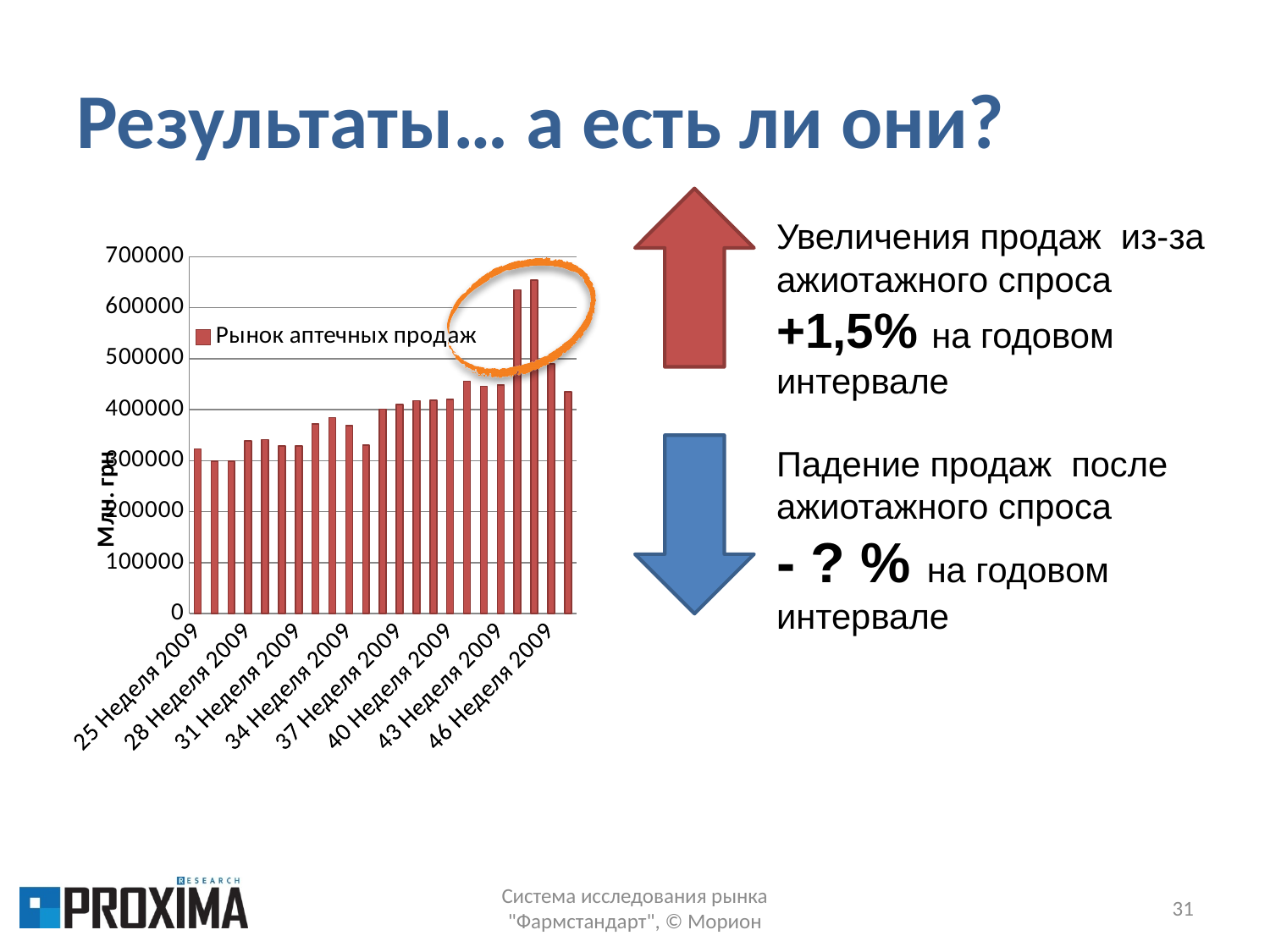
What is the name of the series shown in the chart legend? Рынок аптечных продаж Is the tallest bar in the chart greater or less than 600000? greater Is the value for 46 Неделя 2009 greater or less than 600000? less How many series does the chart legend list? 1 What kind of chart is shown on the slide? bar chart Is the value for 43 Неделя 2009 greater or less than 500000? less Do the values generally rise or fall from 25 Неделя 2009 to 46 Неделя 2009? rise What is the label on the vertical axis of the chart? Млн. грн Which is larger, the value for 25 Неделя 2009 or the value for 40 Неделя 2009? 40 Неделя 2009